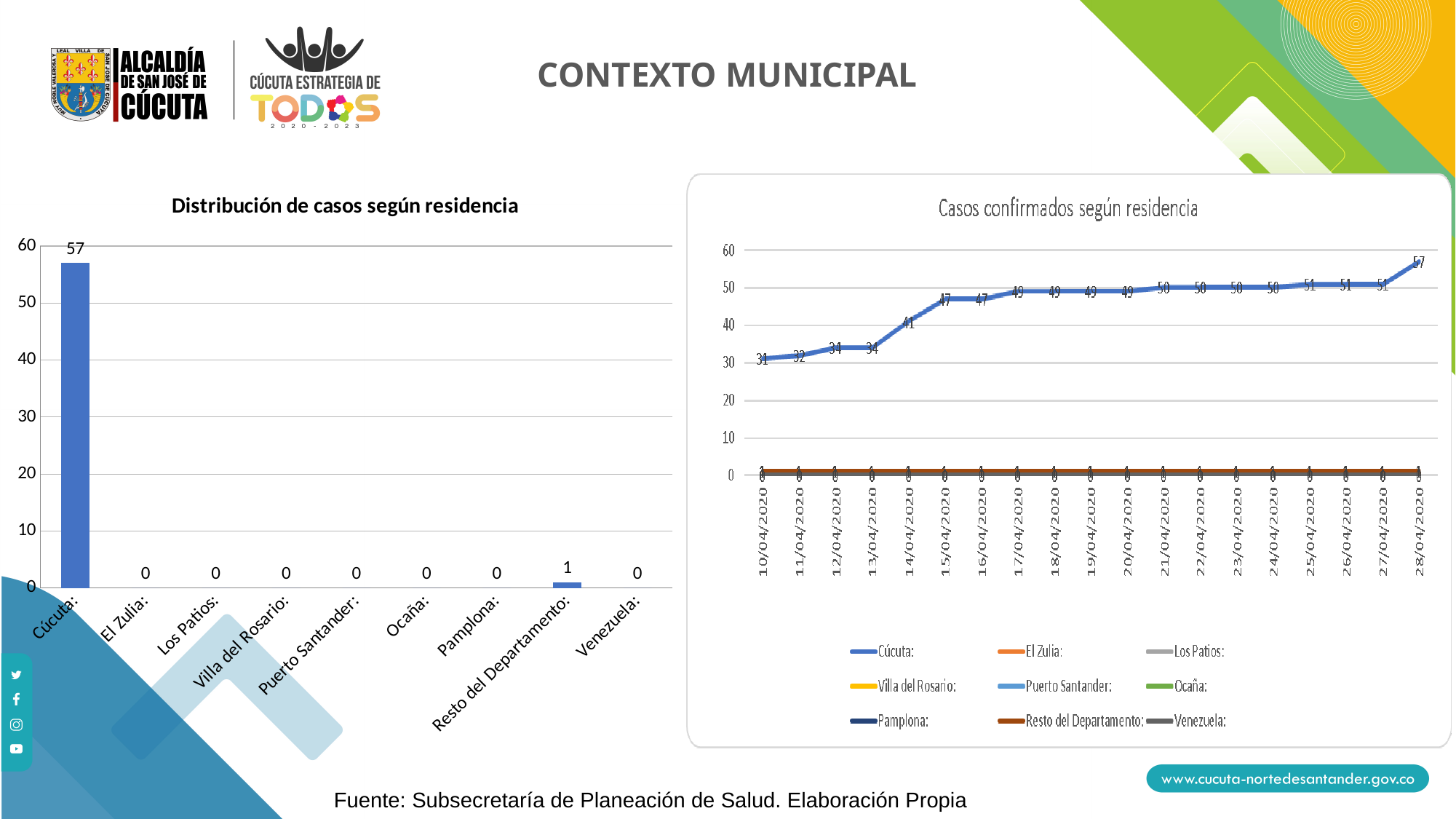
In the chart 'Casos confirmados según residencia', what is the value for Cúcuta on 14/04/2020? 41 In the chart 'Casos confirmados según residencia', what is the value for Cúcuta on 10/04/2020? 31 In the chart 'Distribución de casos según residencia', what is the value for Resto del Departamento? 1 What kind of chart is 'Distribución de casos según residencia'? Bar chart In the chart 'Casos confirmados según residencia', what is the value for Cúcuta on 28/04/2020? 57 In the chart 'Distribución de casos según residencia', what is the value for Cúcuta? 57 In the chart 'Distribución de casos según residencia', how many categories are shown on the x axis? 9 In the chart 'Casos confirmados según residencia', does the Cúcuta series rise or fall from 10/04/2020 to 28/04/2020? Rise In the chart 'Distribución de casos según residencia', which category has the highest value? Cúcuta What kind of chart is 'Casos confirmados según residencia'? Line chart In the chart 'Casos confirmados según residencia', how many series does the legend list? 9 In the chart 'Distribución de casos según residencia', what is the difference between the values for Cúcuta and Resto del Departamento? 56